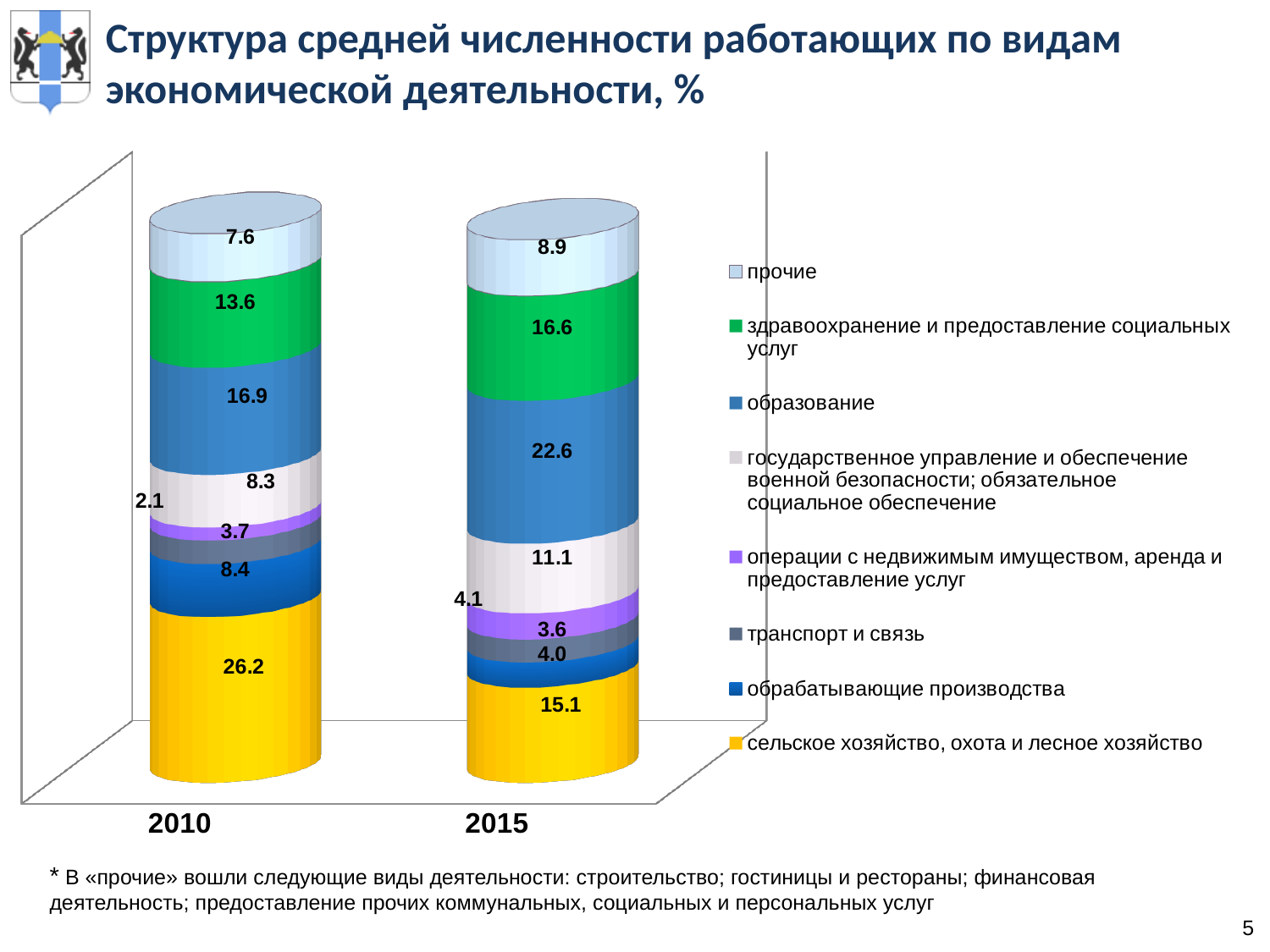
What is the value for сельское хозяйство, охота и лесное хозяйство in 2010? 26.2 What is the value for обрабатывающие производства in 2010? 8.4 What is the value for прочие in 2015? 8.9 Which year has the larger value for здравоохранение и предоставление социальных услуг, 2010 or 2015? 2015 By how much did the value for образование change from 2010 to 2015? 5.7 What is the difference between the сельское хозяйство, охота и лесное хозяйство values in 2010 and 2015? 11.1 What kind of chart is shown on the slide? stacked bar chart How many years are shown on the x axis? 2 Does the value for сельское хозяйство, охота и лесное хозяйство rise or fall from 2010 to 2015? fall What is the value for образование in 2015? 22.6 How many series does the legend list? 8 What is the value for здравоохранение и предоставление социальных услуг in 2010? 13.6